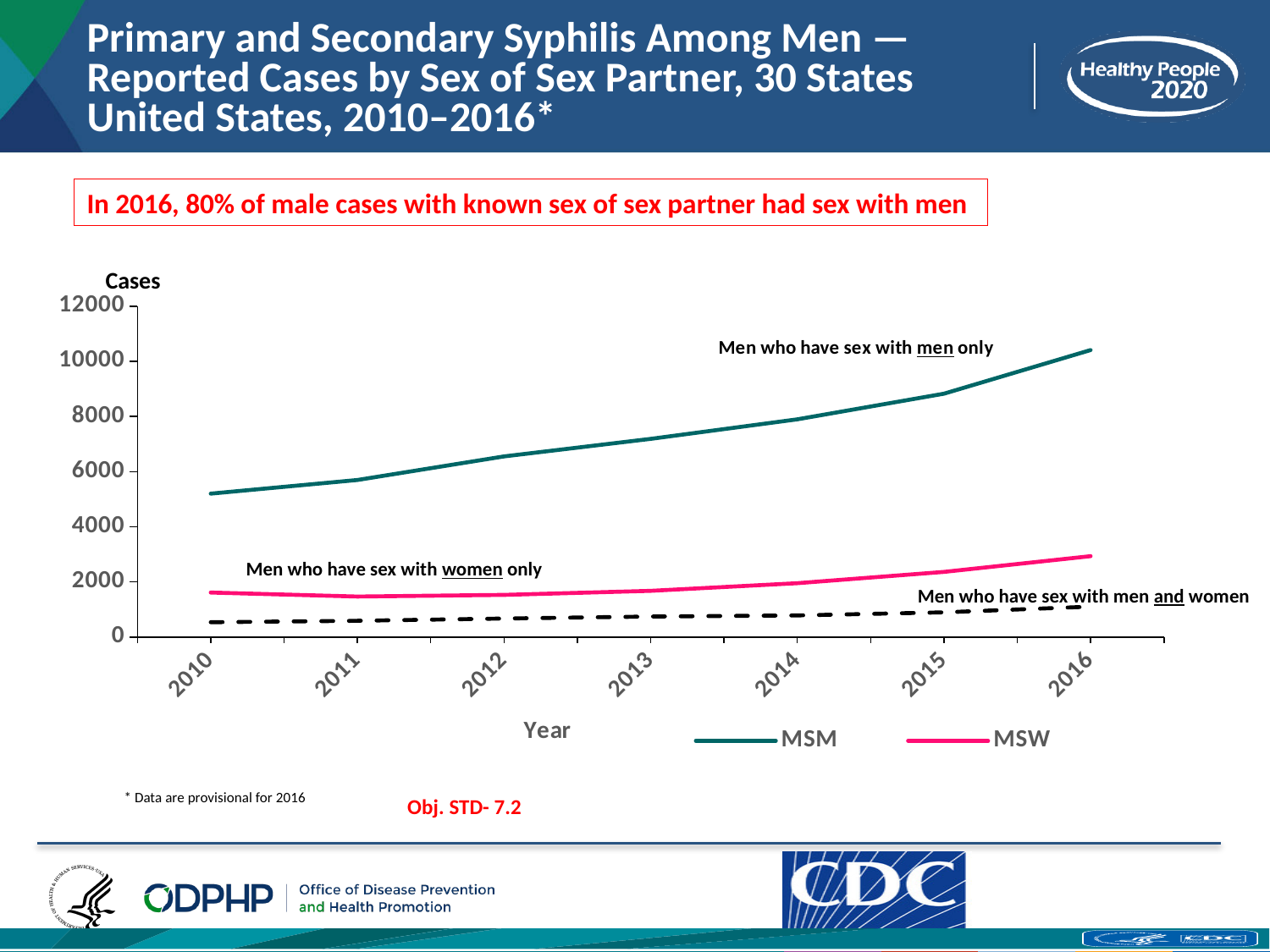
How many series does the legend list? 2 What kind of chart is shown on the slide? line chart Which group has the lowest number of cases across the chart? Men who have sex with men and women Which group has the highest number of cases across the chart? Men who have sex with men only Is the value for MSW in 2010 greater or less than 2000? less Is the value for MSW in 2016 greater or less than 2000? greater What is the label on the y axis of the chart? Cases In 2016, which is larger: the number of cases for MSM or for MSW? MSM Does the number of cases among men who have sex with men only rise or fall from 2010 to 2016? rise Is the value for MSM in 2016 greater or less than 10000? greater How many years are shown on the x axis? 7